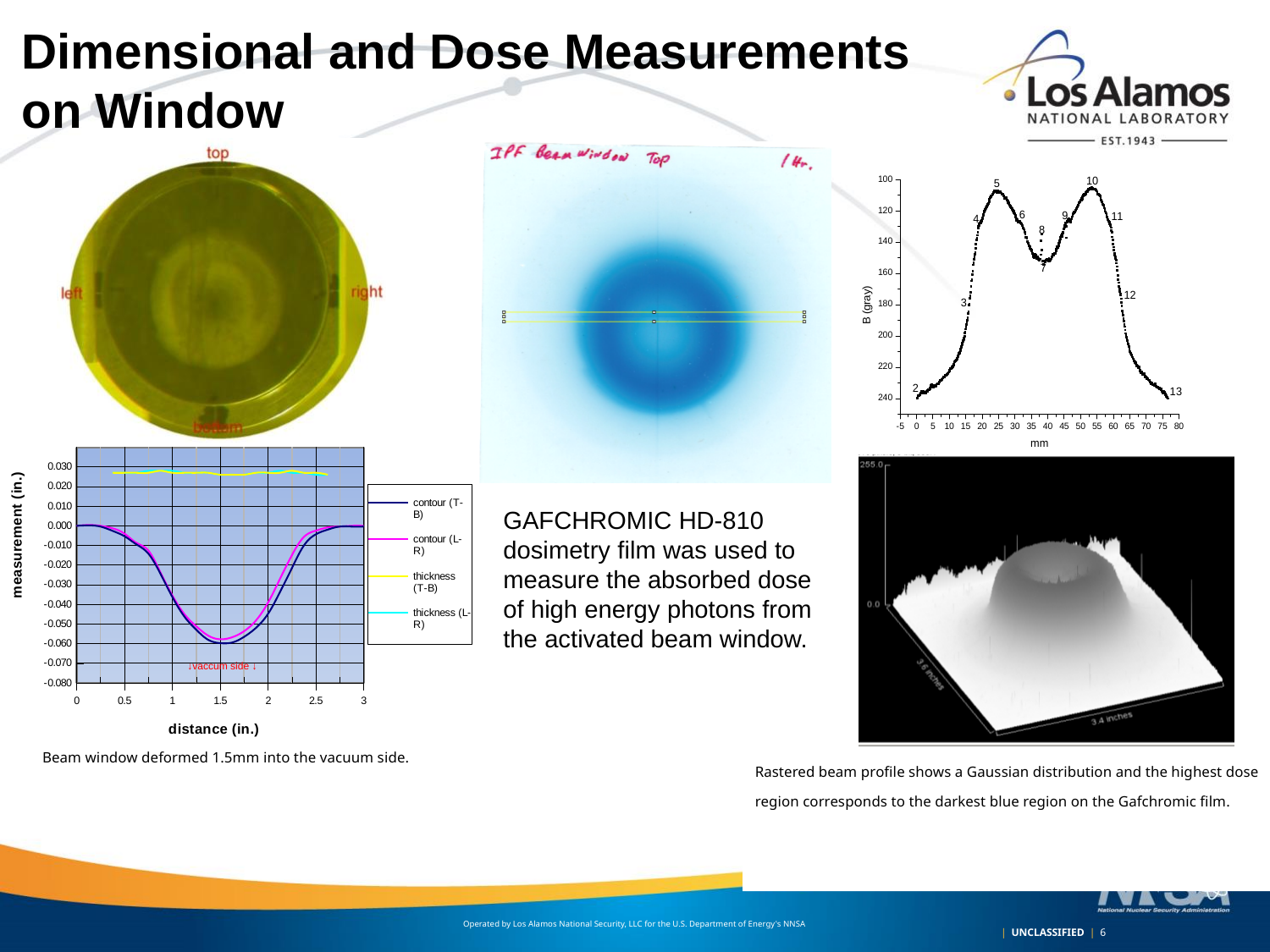
What kind of chart is the top-right chart with the B (gray) axis? scatter plot In the bottom-left chart, does the contour (T-B) series rise or fall as distance increases from 0.5 to 1.5 in.? fall How many series does the legend of the bottom-left chart list? 4 What is the x-axis label of the bottom-left chart? distance (in.) What is the x-axis label of the top-right chart with the B (gray) axis? mm In the top-right chart, is the B (gray) value at the point labelled 5 greater or less than 120? less What is the y-axis label of the bottom-left chart? measurement (in.) In the top-right chart, is the B (gray) value at the point labelled 13 greater or less than 220? greater What kind of chart is the bottom-left chart with the distance (in.) axis? line chart In the bottom-left chart, is the value of the thickness (T-B) series at a distance of 1 in. greater or less than 0.020? greater In the bottom-left chart, does the contour (L-R) series rise or fall as distance increases from 1.5 to 2.5 in.? rise